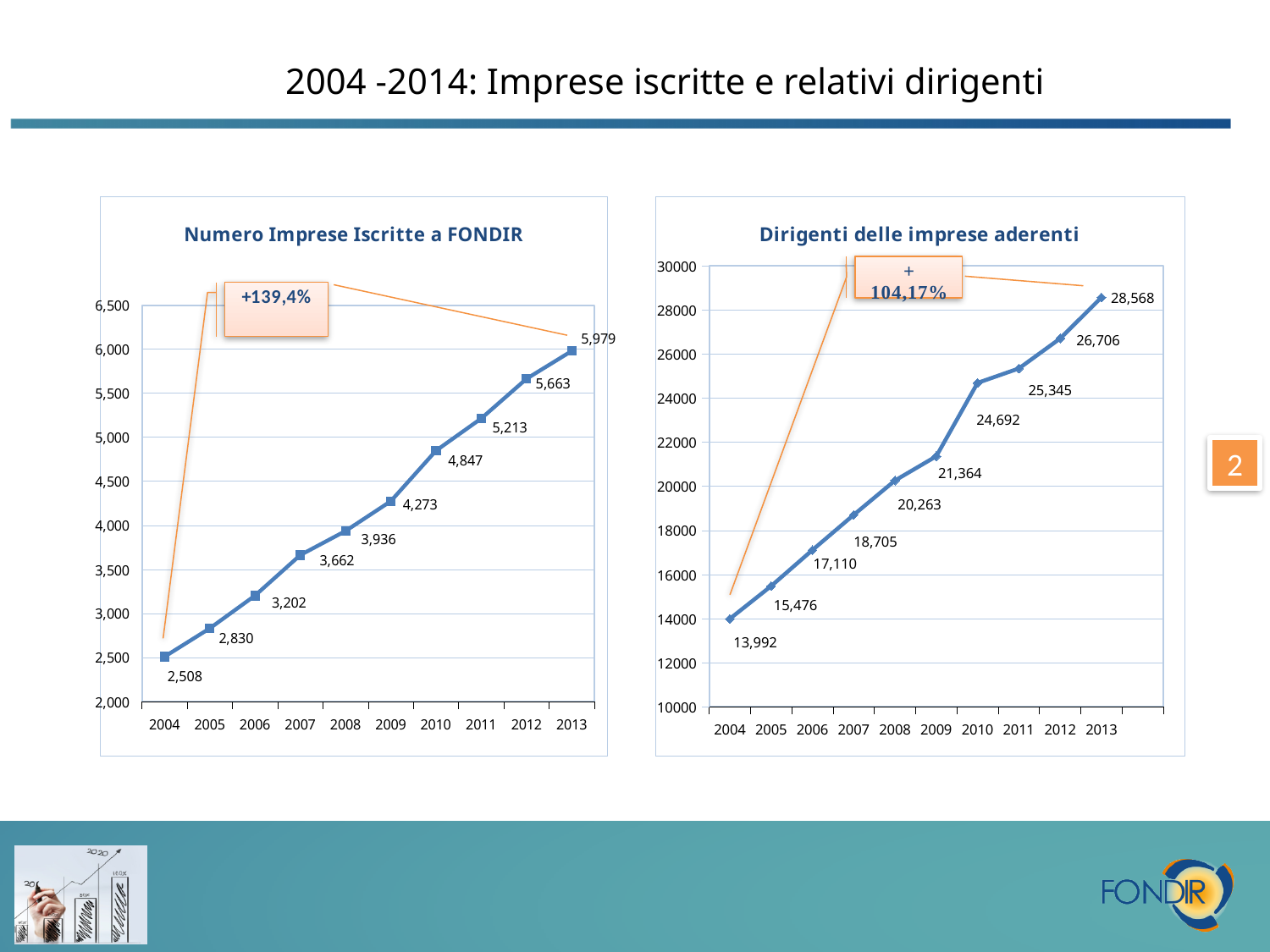
How many years are plotted on the x axis of the chart titled "Dirigenti delle imprese aderenti"? 10 What kind of chart is the chart titled "Numero Imprese Iscritte a FONDIR"? Line chart In the chart titled "Numero Imprese Iscritte a FONDIR", which year has the lowest value? 2004 In the chart titled "Dirigenti delle imprese aderenti", do the values rise or fall from 2004 to 2013? Rise In the chart titled "Dirigenti delle imprese aderenti", what is the value for 2004? 13,992 In the chart titled "Dirigenti delle imprese aderenti", what is the value for 2010? 24,692 In the chart titled "Dirigenti delle imprese aderenti", which year has the highest value? 2013 In the chart titled "Numero Imprese Iscritte a FONDIR", what is the value for 2013? 5,979 In the chart titled "Dirigenti delle imprese aderenti", what is the difference between the values for 2010 and 2009? 3,328 In the chart titled "Numero Imprese Iscritte a FONDIR", what is the difference between the values for 2013 and 2012? 316 In the chart titled "Numero Imprese Iscritte a FONDIR", which is larger, the value for 2008 or the value for 2009? 2009 In the chart titled "Numero Imprese Iscritte a FONDIR", what is the value for 2004? 2,508